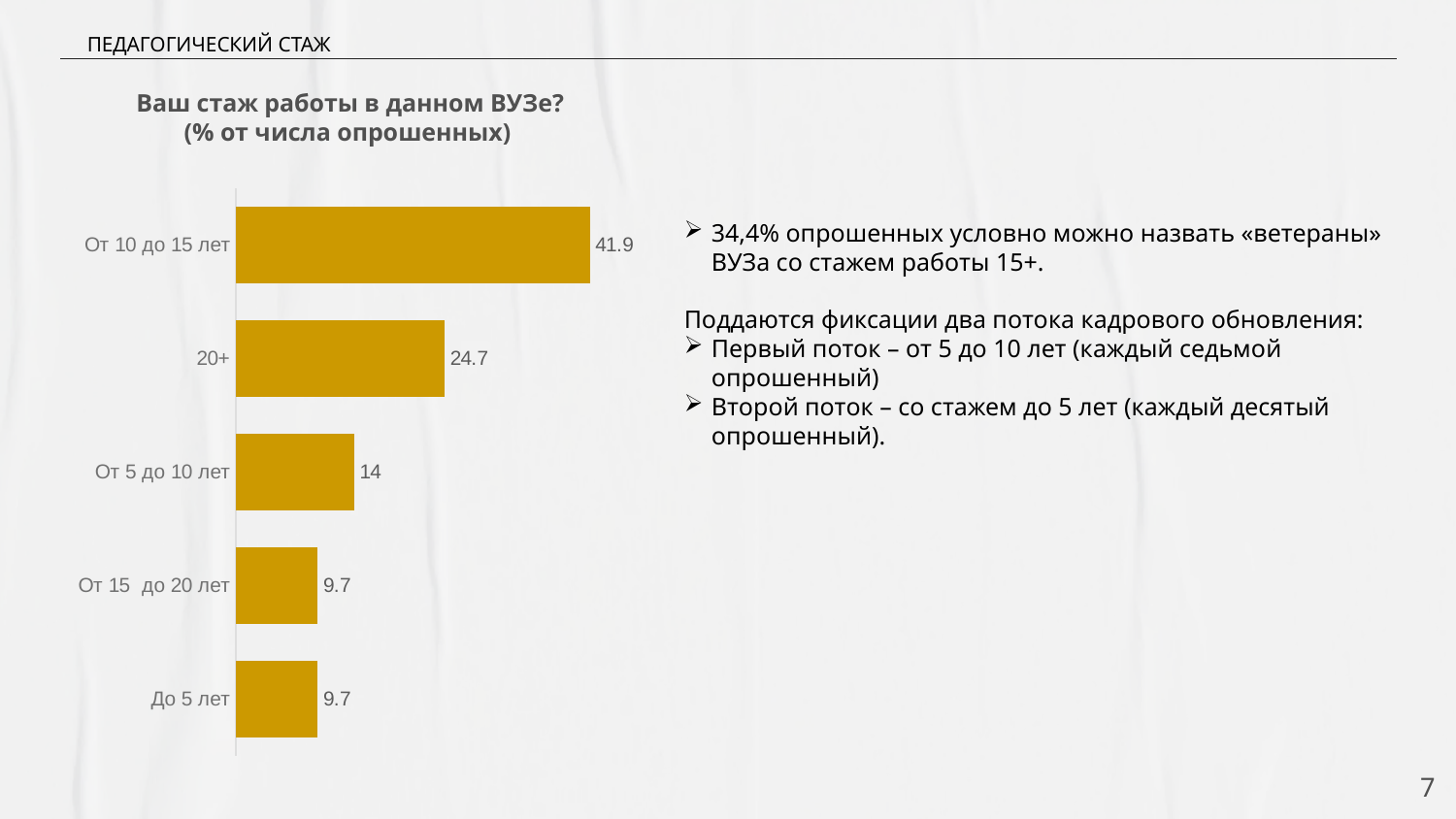
What is the value for the category "От 10 до 15 лет"? 41.9 What is the title of the chart? Ваш стаж работы в данном ВУЗе? (% от числа опрошенных) Which category has the highest value? От 10 до 15 лет What is the value for the category "До 5 лет"? 9.7 How many categories are shown in the chart? 5 Which is larger, the value for "От 5 до 10 лет" or the value for "От 15 до 20 лет"? От 5 до 10 лет What type of chart is shown on the slide? Bar chart What is the value for the category "20+"? 24.7 What is the value for the category "От 5 до 10 лет"? 14 Which is larger, the value for "20+" or the value for "От 5 до 10 лет"? 20+ What is the difference between the values for "От 10 до 15 лет" and "20+"? 17.2 What is the difference between the values for "20+" and "От 5 до 10 лет"? 10.7